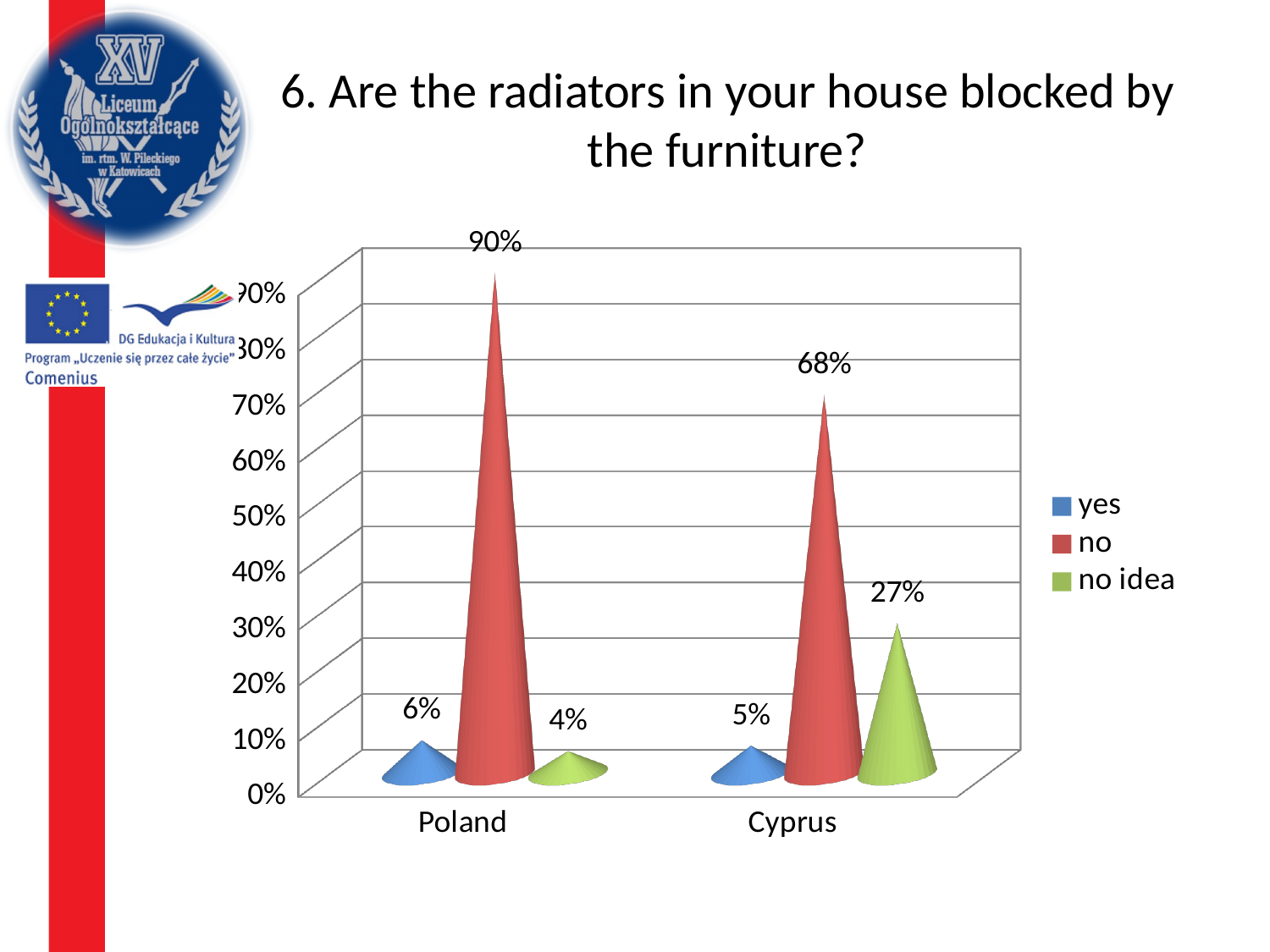
What percentage of respondents in Cyprus answered "yes"? 5% What percentage of respondents in Cyprus answered "no idea"? 27% Which answer has the lowest percentage in Poland? no idea What percentage of respondents in Poland answered "no idea"? 4% How many countries are shown on the x axis? 2 Which country has the higher "no" percentage? Poland How many series does the legend list? 3 What is the difference between the "no idea" percentages for Cyprus and Poland? 23% What is the difference between the "no" percentages for Poland and Cyprus? 22% Is the "no idea" value for Cyprus larger or smaller than the "yes" value for Cyprus? larger Which colour represents the "no" series in the legend? red What percentage of respondents in Poland answered "no"? 90%